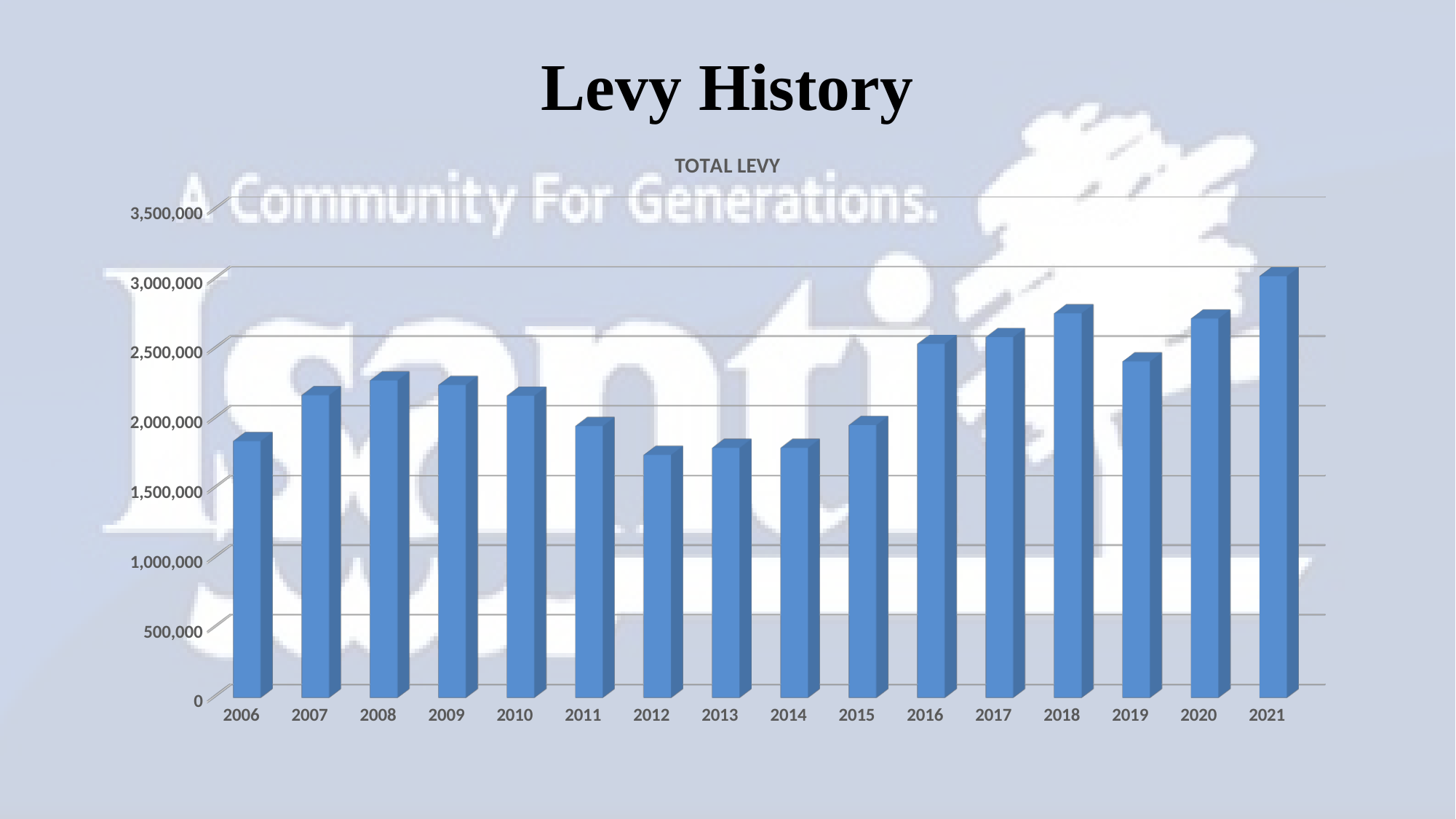
Is the total levy for 2021 greater or less than 2,500,000? greater Which year has the lowest total levy? 2012 How many years are shown on the x axis of the chart? 16 Which year has the highest total levy? 2021 Is the total levy for 2012 greater or less than 2,000,000? less Is the total levy for 2008 greater or less than 2,000,000? greater What is the title of the chart? TOTAL LEVY What kind of chart is shown on the slide? Bar chart Does the total levy rise or fall from 2008 to 2012? fall Which year has a larger total levy, 2006 or 2021? 2021 Which year has a larger total levy, 2018 or 2019? 2018